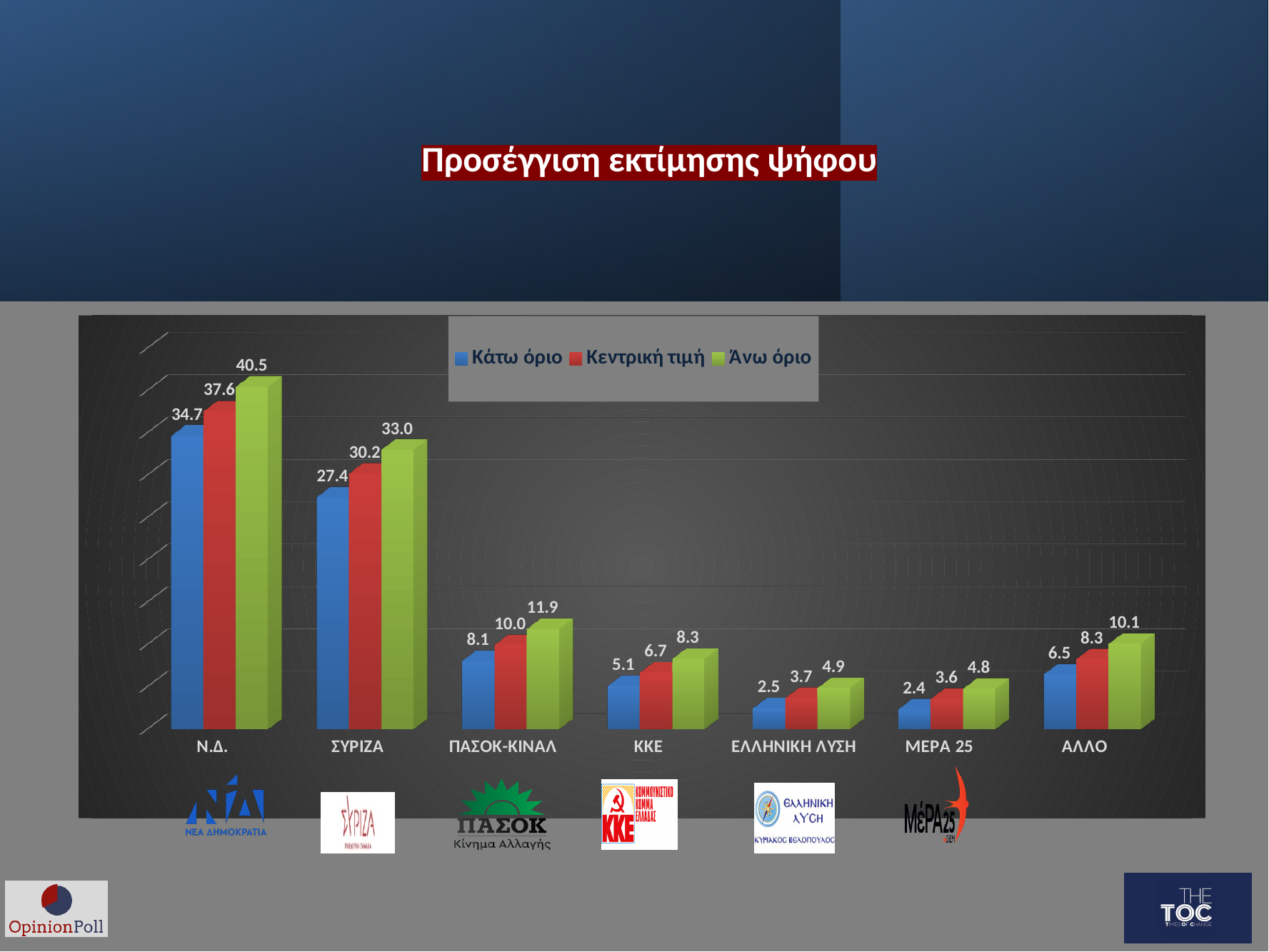
What is the difference between the Άνω όριο and Κάτω όριο values for Ν.Δ.? 5.8 What is the Άνω όριο value for ΣΥΡΙΖΑ? 33.0 What is the Κεντρική τιμή value for Ν.Δ.? 37.6 How many series does the legend list? 3 Which is larger, the Κεντρική τιμή value for ΑΛΛΟ or for ΚΚΕ? ΑΛΛΟ What is the Κάτω όριο value for ΠΑΣΟΚ-ΚΙΝΑΛ? 8.1 What is the Κεντρική τιμή value for ΚΚΕ? 6.7 How many categories are shown on the x axis? 7 What is the difference between the Κεντρική τιμή values for Ν.Δ. and ΣΥΡΙΖΑ? 7.4 Which category has the lowest Κάτω όριο value? ΜΕΡΑ 25 Which category has the highest Κεντρική τιμή value? Ν.Δ. What kind of chart is shown on the slide? Bar chart